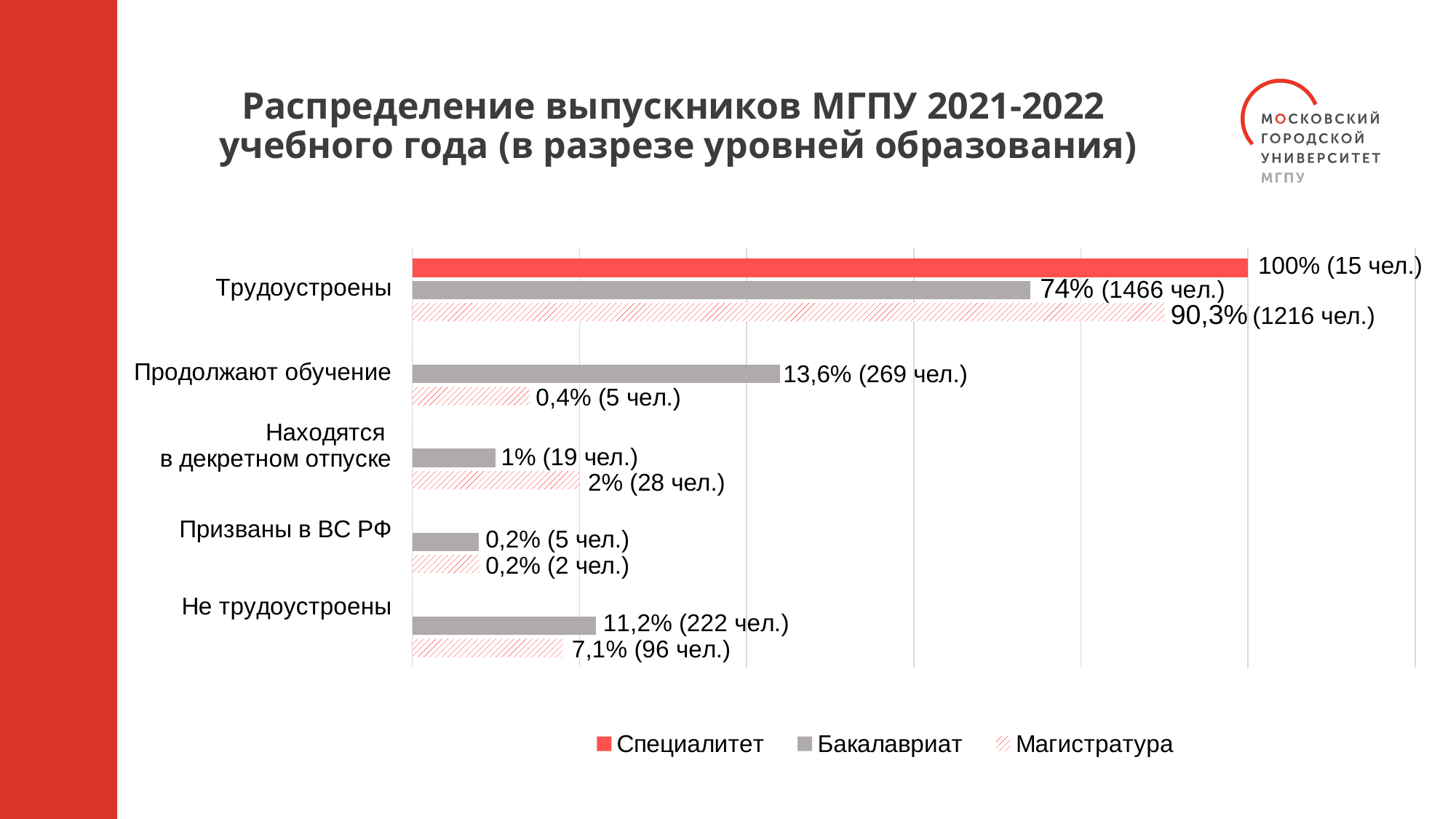
What percentage of Магистратура graduates are in the category Продолжают обучение? 0,4% How many Бакалавриат graduates are in the category Не трудоустроены? 222 чел. What is the value for Магистратура in the category Трудоустроены? 90,3% (1216 чел.) Which category has the lowest value for Магистратура? Призваны в ВС РФ How many series does the legend list? 3 What type of chart is shown on the slide? bar chart What is the difference in percentage points between Бакалавриат and Магистратура in the category Не трудоустроены? 4,1 What is the value for Специалитет in the category Трудоустроены? 100% (15 чел.) Which category has the highest value for Бакалавриат? Трудоустроены What is the value for Бакалавриат in the category Трудоустроены? 74% (1466 чел.) In the category Находятся в декретном отпуске, which is larger: Бакалавриат or Магистратура? Магистратура How many categories are shown on the vertical axis? 5